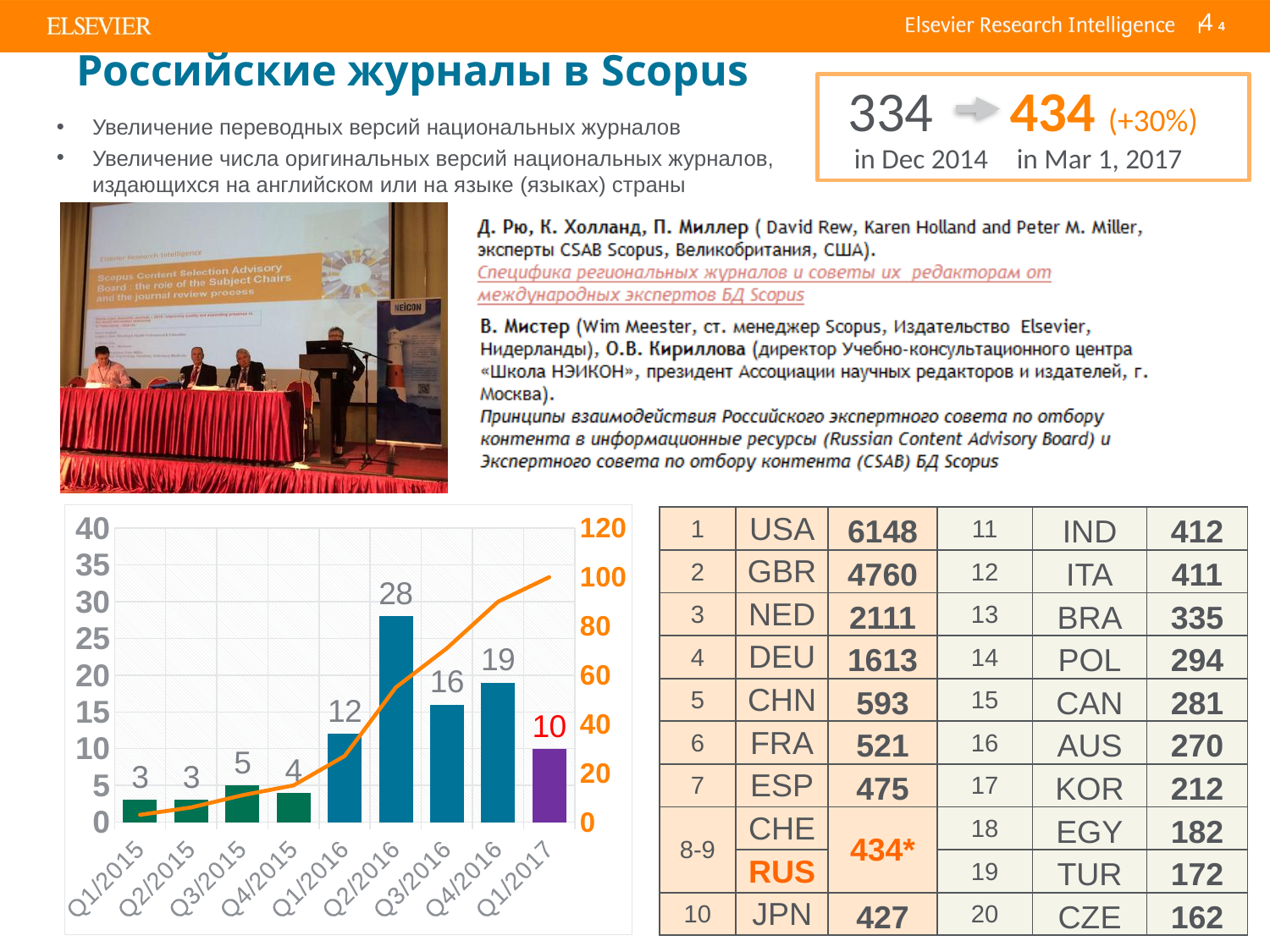
What is the bar value for Q4/2016 in the chart? 19 What colour is the bar for Q1/2017 in the chart? purple What is the difference between the bar values for Q3/2015 and Q4/2015? 1 Does the line in the chart rise or fall from Q1/2015 to Q1/2017? rise Is the line value at Q1/2017 greater or less than 80 on the right-hand axis? greater Is the line value at Q4/2015 greater or less than 40 on the right-hand axis? less What is the difference between the bar values for Q2/2016 and Q3/2016? 12 How many quarters are shown on the x axis of the chart? 9 What is the bar value for Q1/2017 in the chart? 10 Which quarter has the highest bar in the chart? Q2/2016 Which bar is larger, Q1/2016 or Q4/2016? Q4/2016 What is the bar value for Q2/2016 in the chart? 28